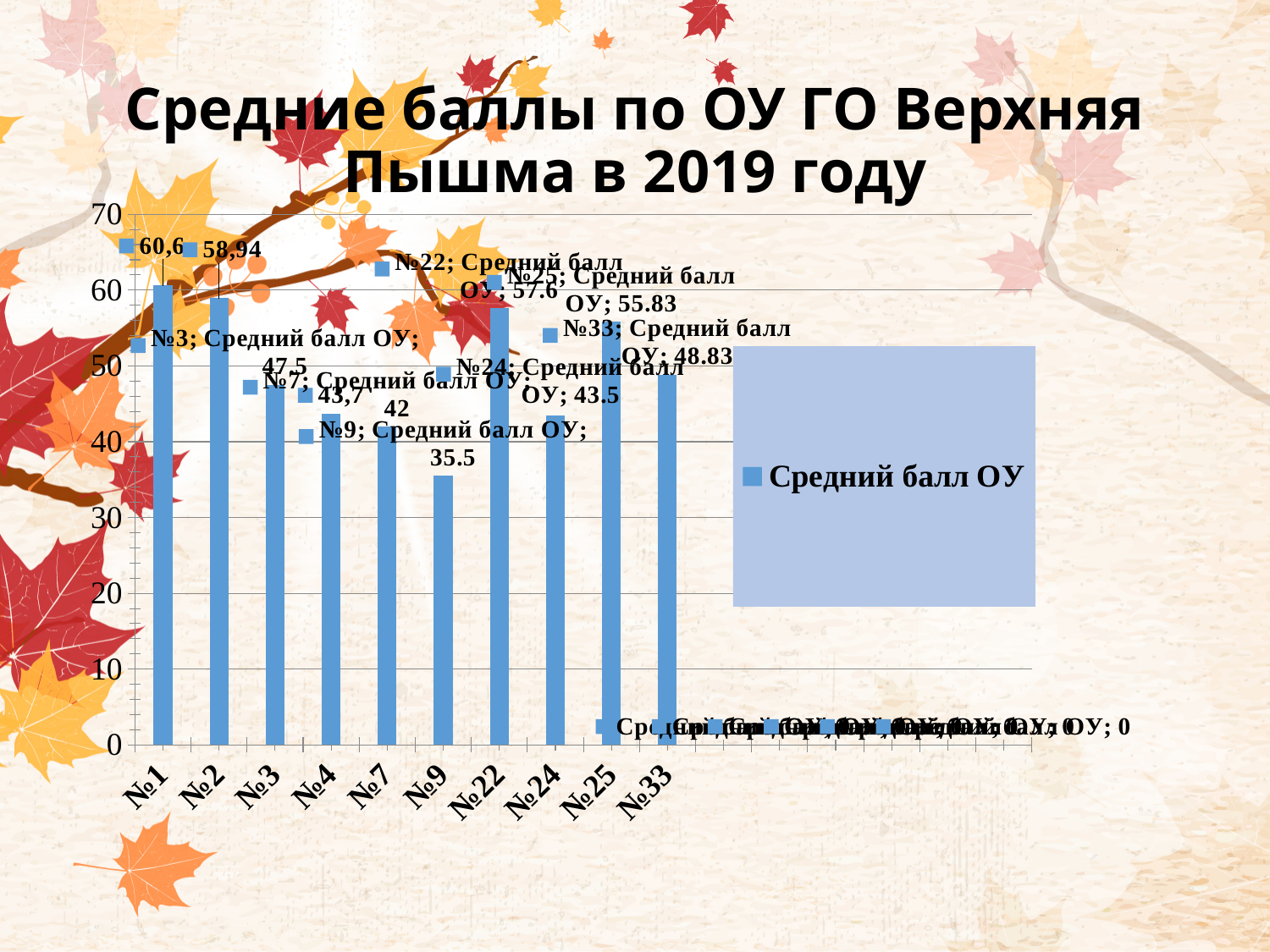
What is the value for №1? 60,6 How many categories are shown on the x axis? 10 What kind of chart is shown on the slide? bar chart What is the difference between the values for №22 and №24? 14.1 What is the value for №7? 42 Which category has the highest value? №1 What is the value for №9? 35.5 Which category has the lowest value? №9 What is the value for №25? 55.83 How many series does the legend list? 1 Is the value for №2 greater or less than 50? greater Which is larger, the value for №3 or the value for №33? №33